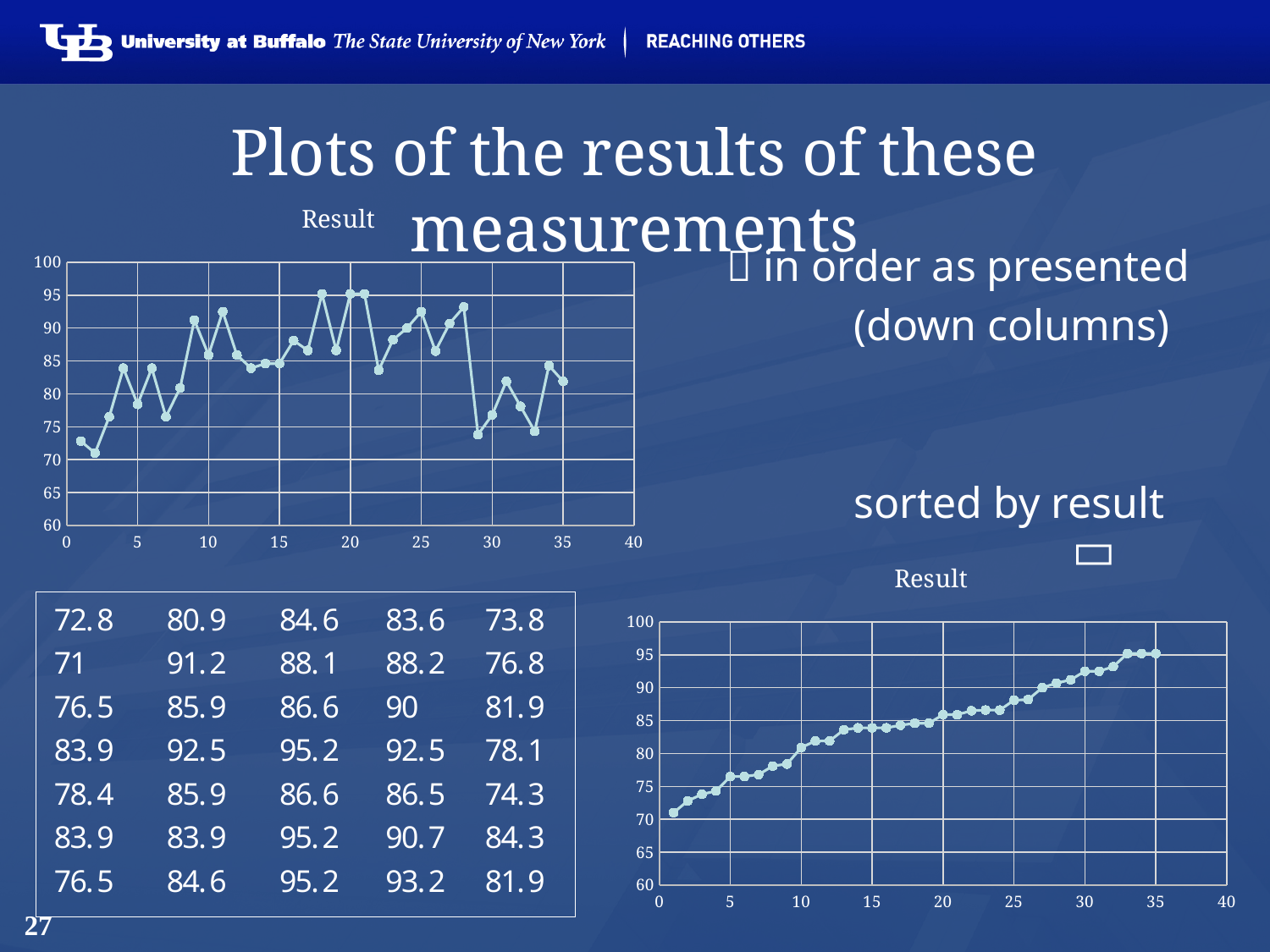
What kind of chart is the top-left chart titled "Result"? line chart In the bottom-right "sorted by result" chart, at which x value is the lowest point? 1 What is the title shown above each of the two charts? Result How many data points are plotted in the top-left "in order as presented" chart? 35 In the bottom-right "sorted by result" chart, is the value at x = 1 greater or less than 75? less In the bottom-right "sorted by result" chart, is the value at x = 35 greater or less than 90? greater How many data points are plotted in the bottom-right "sorted by result" chart? 35 In the top-left "in order as presented" chart, is the value at x = 20 greater or less than 90? greater What is the maximum value shown on the y axis of the top-left chart? 100 In the bottom-right "sorted by result" chart, do the values rise or fall along the x axis? rise